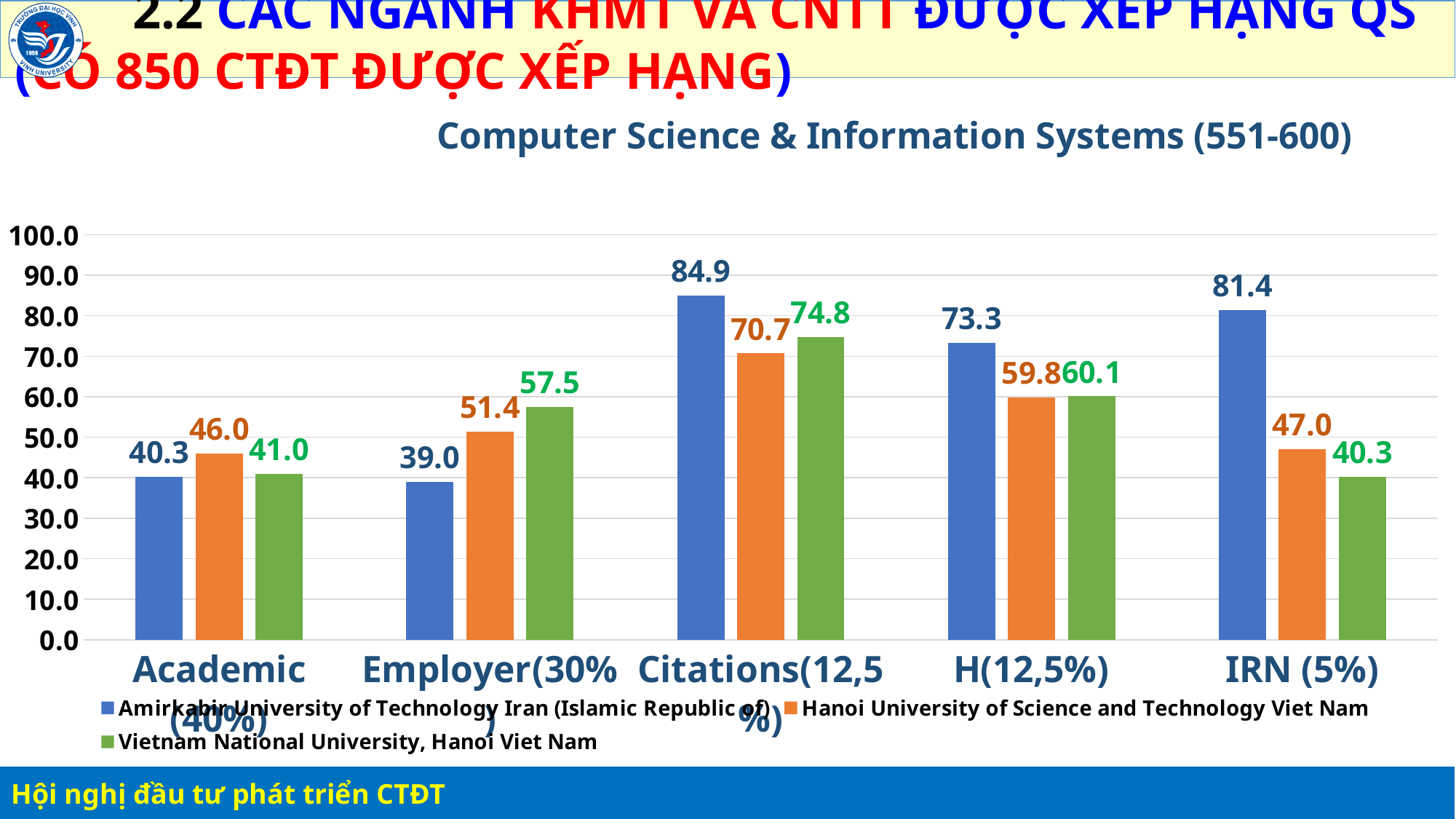
In the Employer(30%) category, which university has the larger value: Amirkabir University of Technology or Vietnam National University, Hanoi? Vietnam National University, Hanoi Viet Nam What kind of chart is shown on the slide? bar chart What is the difference between the Amirkabir University of Technology value and the Hanoi University of Science and Technology value in the IRN (5%) category? 34.4 How many categories are shown on the x axis of the chart? 5 What is the value for Hanoi University of Science and Technology Viet Nam in the Citations(12,5%) category? 70.7 Is the value for Hanoi University of Science and Technology in the H(12,5%) category greater or less than 50.0? greater What is the title of the chart? Computer Science & Information Systems (551-600) What is the value for Amirkabir University of Technology Iran (Islamic Republic of) in the IRN (5%) category? 81.4 What is the value for Vietnam National University, Hanoi Viet Nam in the Employer(30%) category? 57.5 In which category does Amirkabir University of Technology Iran (Islamic Republic of) have its lowest value? Employer(30%) In which category does Amirkabir University of Technology Iran (Islamic Republic of) have its highest value? Citations(12,5%) How many series does the legend list? 3